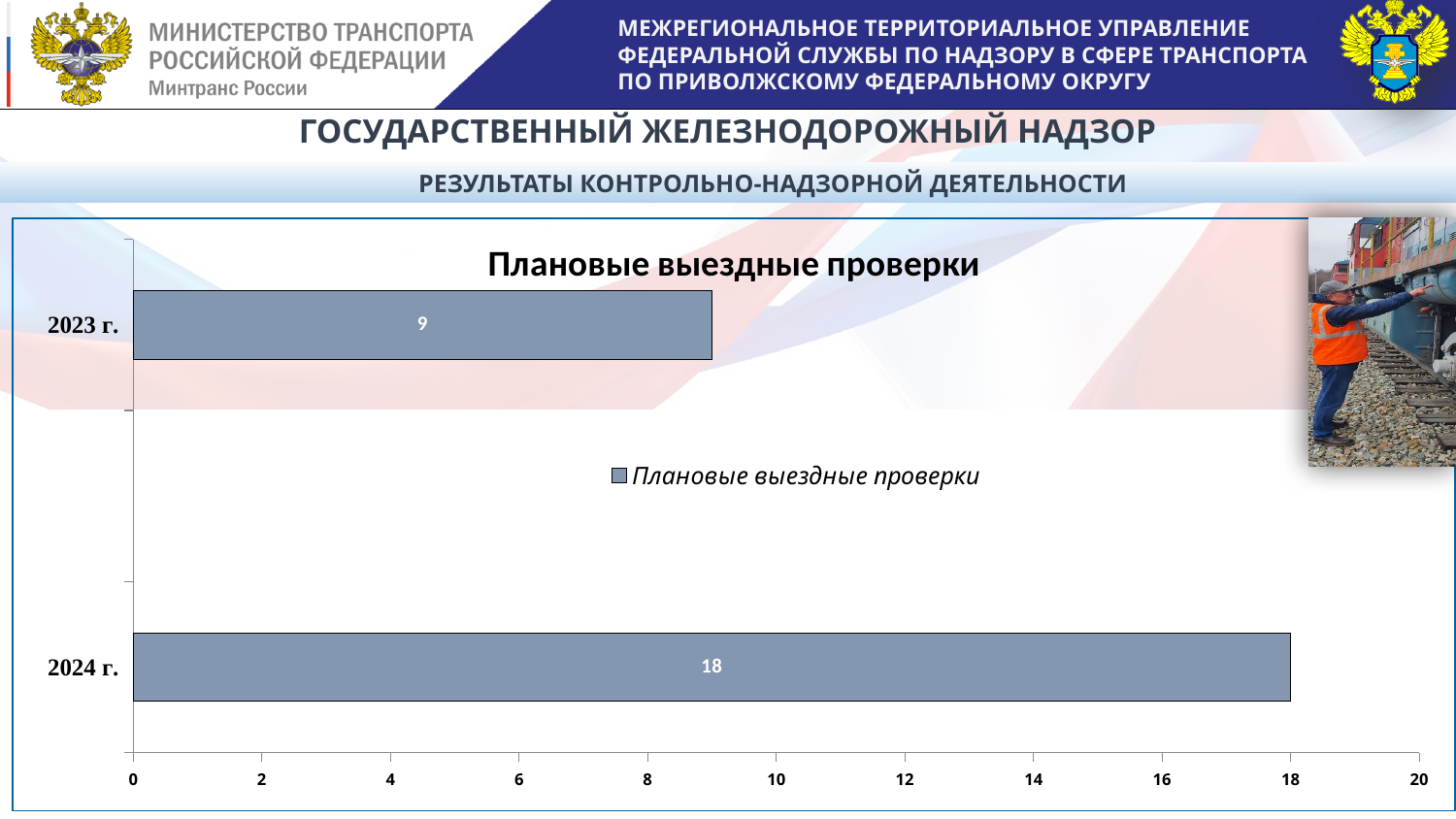
Which year has the highest value of planned on-site inspections? 2024 г. What is the value for 2023 г. in the chart? 9 Is the value for 2023 г. greater or less than 10? less Which year has the lowest value of planned on-site inspections? 2023 г. What is the title of the chart? Плановые выездные проверки What is the difference between the values for 2024 г. and 2023 г.? 9 How many categories are shown in the chart? 2 What kind of chart is shown on the slide? Bar chart Which is larger, the value for 2023 г. or the value for 2024 г.? 2024 г. Is the value for 2024 г. greater or less than 10? greater How many series does the legend list? 1 What is the value for 2024 г. in the chart? 18